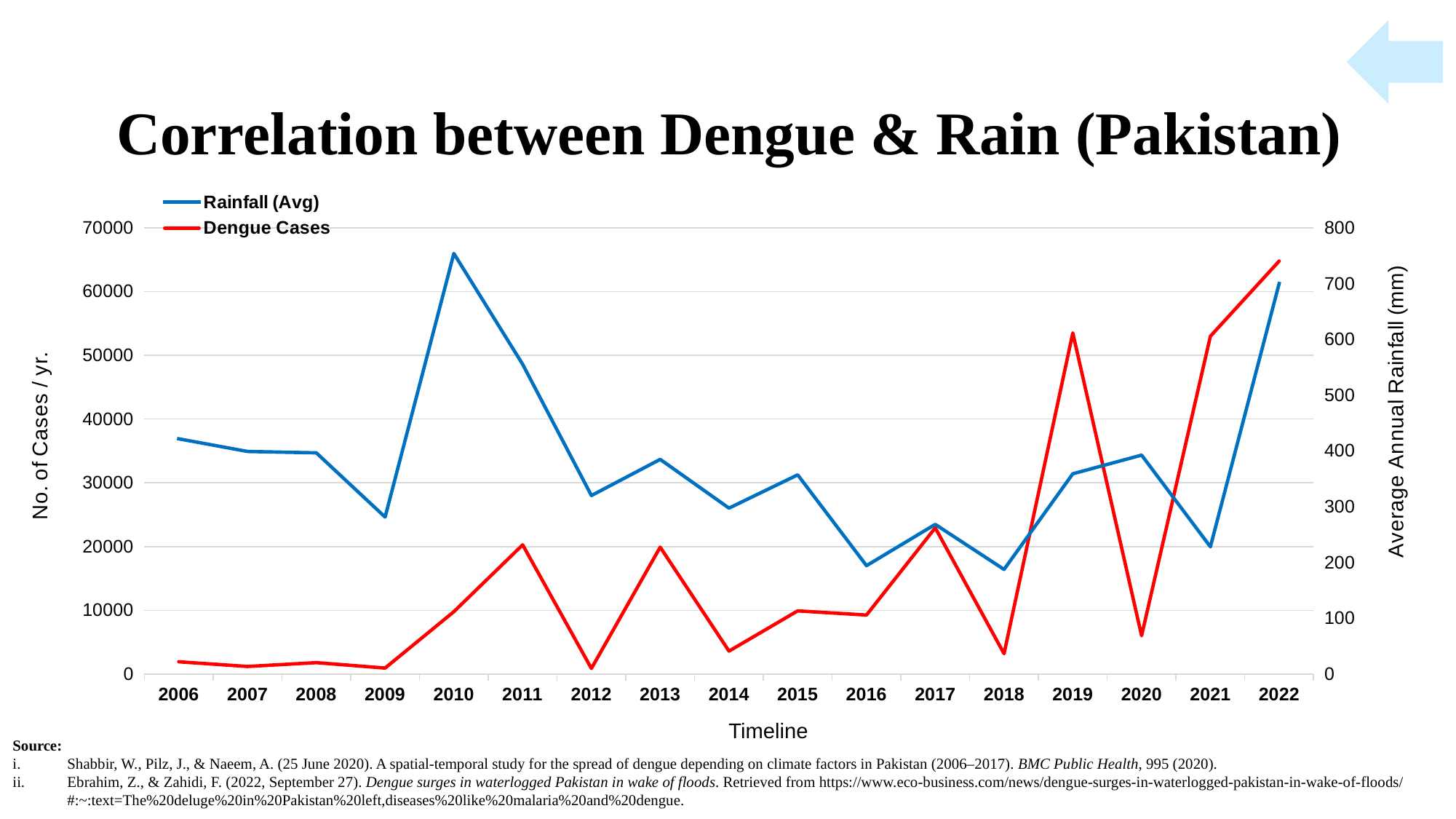
Which year has more Dengue Cases, 2019 or 2022? 2022 Is the Dengue Cases value for 2012 greater or less than 10000? less In which year is the Rainfall (Avg) series at its highest? 2010 In which year is the Dengue Cases series at its highest? 2022 Does the Rainfall (Avg) series rise or fall from 2010 to 2012? fall What is the label of the right-hand vertical axis? Average Annual Rainfall (mm) How many years are shown on the x axis? 17 Is the Rainfall (Avg) value for 2009 greater or less than 300? less Is the Dengue Cases value for 2019 greater or less than 50000? greater How many series does the legend list? 2 What kind of chart is shown on the slide? line chart